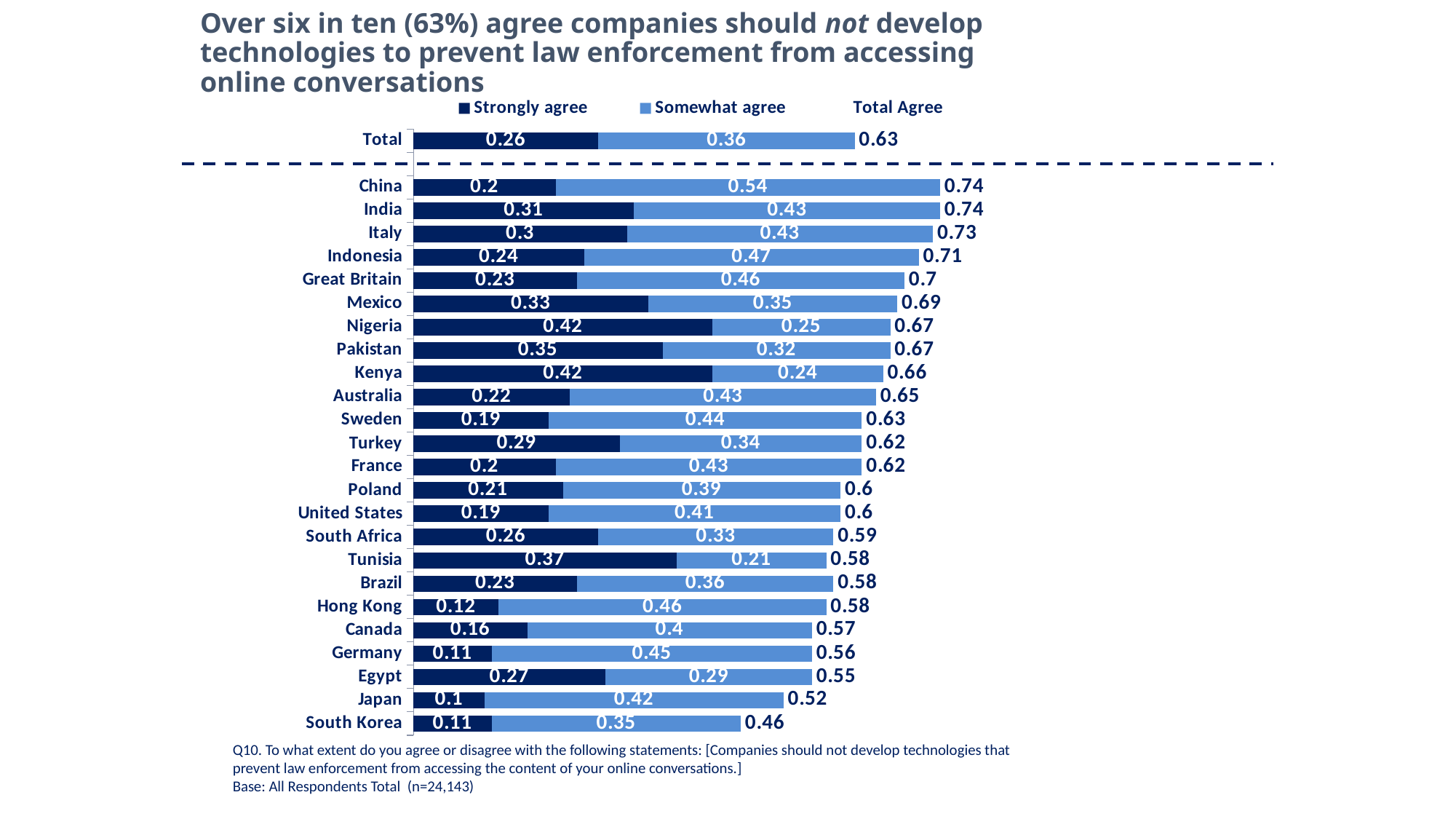
How many countries are shown in the chart, excluding the Total bar? 24 Which country has the lowest Strongly agree value? Japan Which country has the highest Somewhat agree value? China What is the total of the stacked bar for Tunisia? 0.58 What type of chart is shown on the slide? Stacked bar chart What is the Somewhat agree value for China? 0.54 What is the Strongly agree value for Nigeria? 0.42 What is the Total Agree value for Germany? 0.56 Which country has the lowest Total Agree value? South Korea Which has a larger Strongly agree value, Mexico or Sweden? Mexico What is the difference between the Total Agree values for China and South Korea? 0.28 Which category is shown above the dashed line, separated from the countries? Total